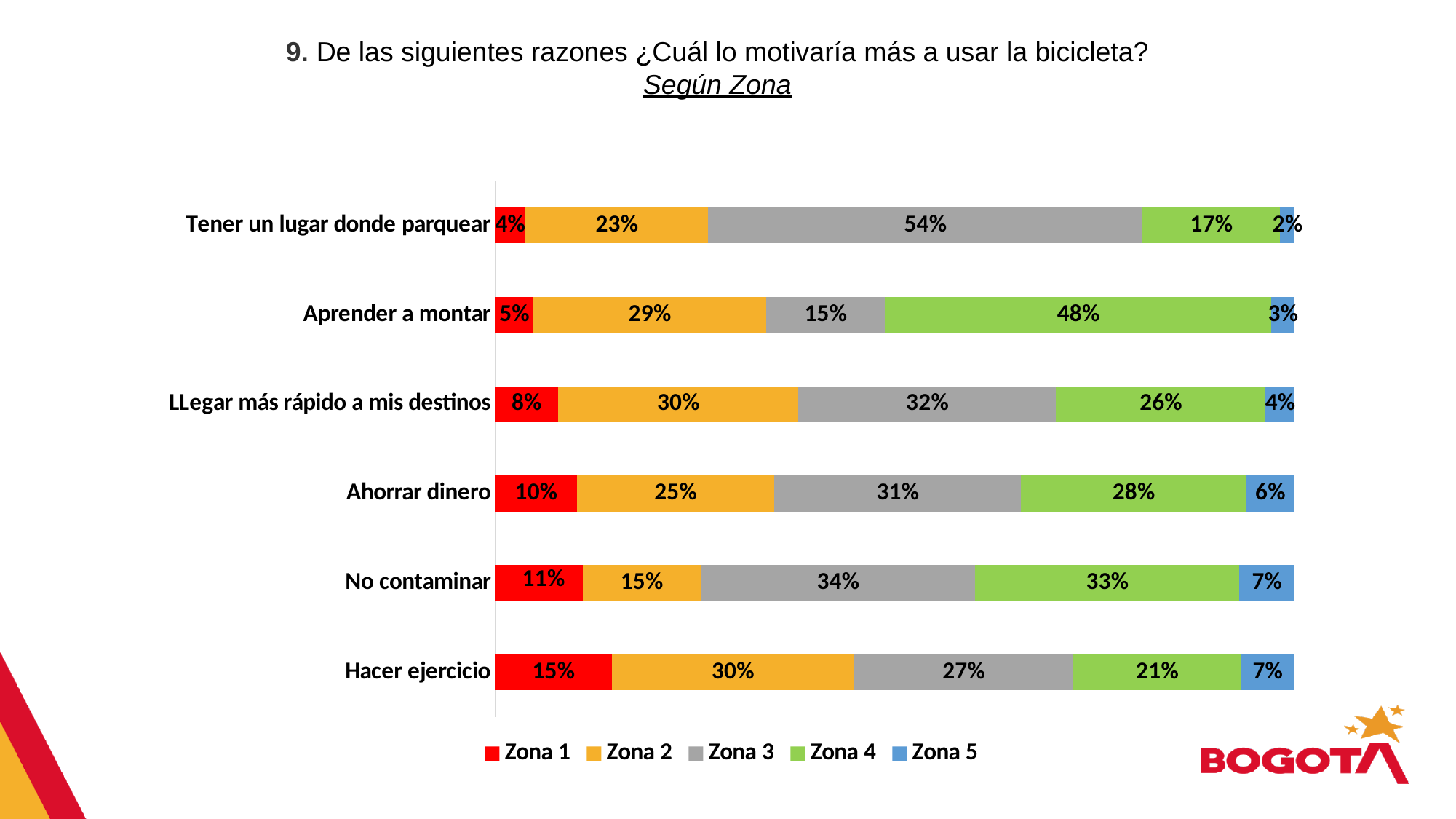
What is the Zona 5 value for "No contaminar"? 7% What is the difference between the Zona 2 values for "Aprender a montar" and "No contaminar"? 14% What is the total of the stacked bar for "LLegar más rápido a mis destinos"? 100% What is the Zona 4 value for "Aprender a montar"? 48% How many categories are shown on the chart? 6 Which category has the highest Zona 3 value? Tener un lugar donde parquear How many series does the legend list? 5 What kind of chart is shown on the slide? Stacked bar chart What is the Zona 1 value for "Hacer ejercicio"? 15% What is the Zona 3 value for "Tener un lugar donde parquear"? 54% Which is larger for "Ahorrar dinero": the Zona 3 value or the Zona 4 value? Zona 3 Which category has the lowest Zona 1 value? Tener un lugar donde parquear